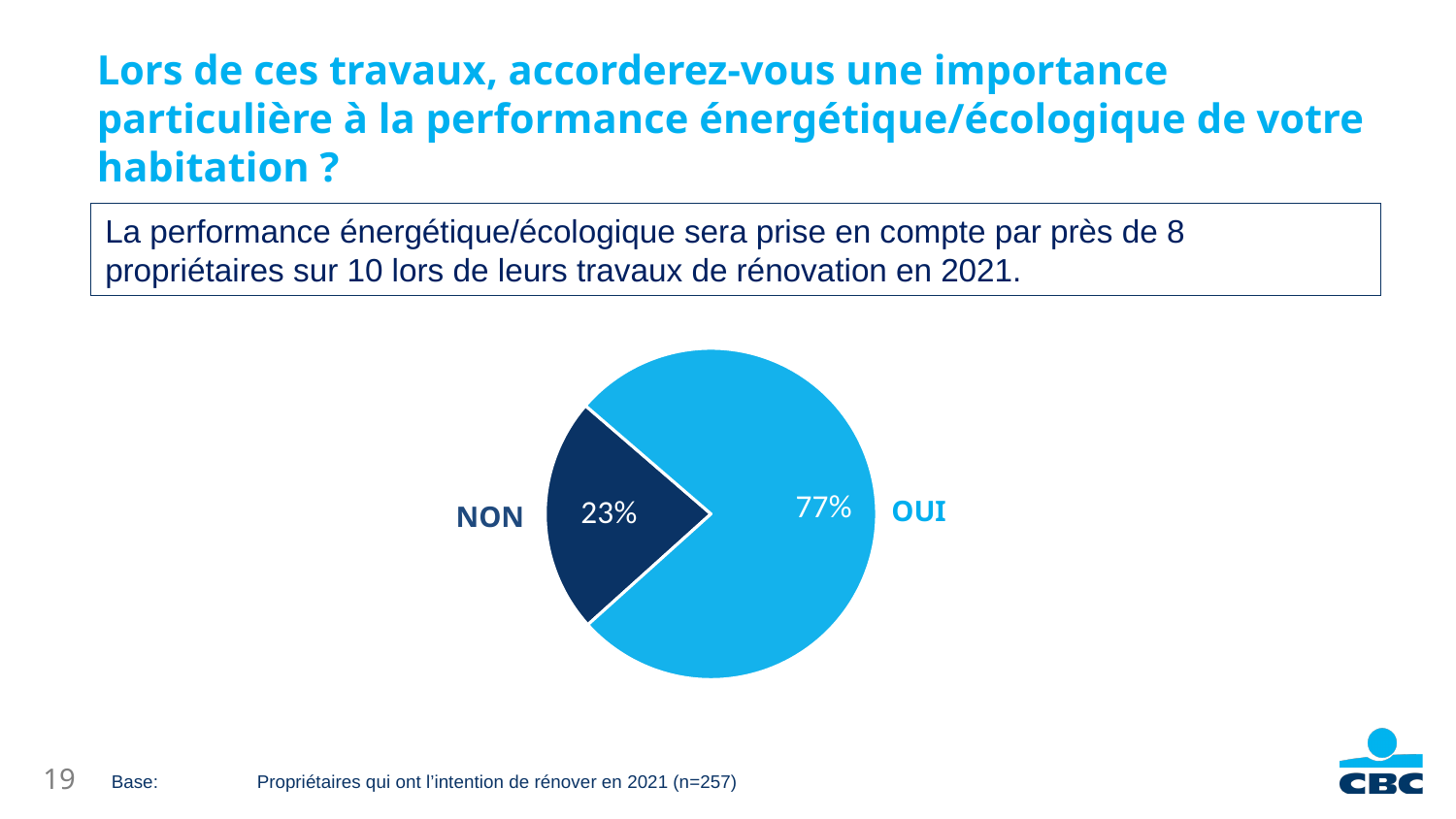
What colour is the NON slice of the pie chart? Dark blue What is the difference in percentage points between OUI and NON? 54 What kind of chart is shown on the slide? Pie chart Which category has the smallest share of the pie? NON What percentage of respondents answered OUI? 77% What percentage of respondents answered NON? 23% What is the sample size (n) stated in the base note below the chart? 257 What share of the pie does the OUI slice represent? 77% How many slices does the pie chart have? 2 Which category has the largest share of the pie? OUI Which is larger, the share for OUI or the share for NON? OUI Is the share for NON greater or less than 50%? less